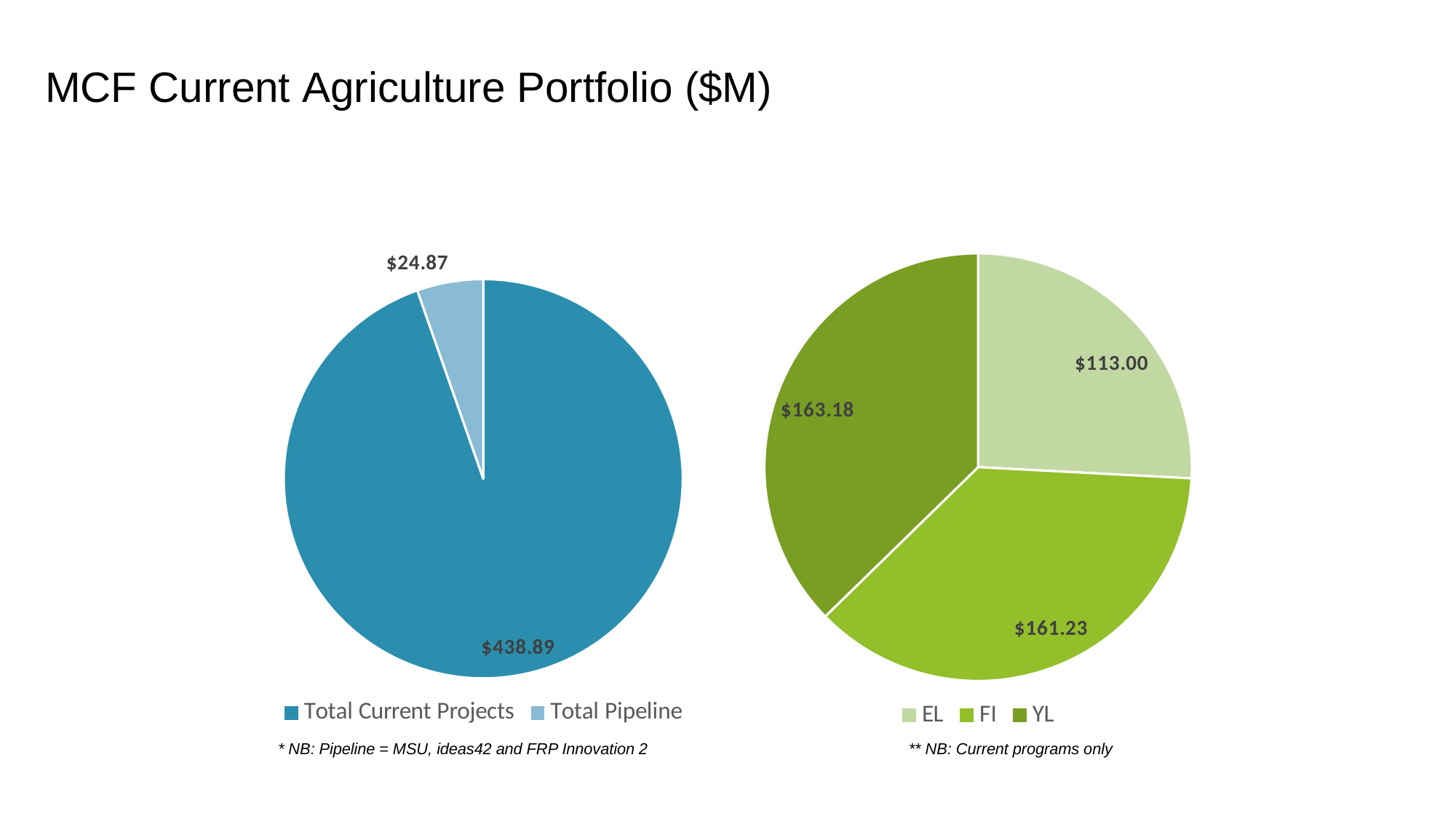
In the left pie chart, what is the value for Total Pipeline? $24.87 In the left pie chart, which category has the largest value? Total Current Projects What type of chart is the left chart on the slide? Pie chart How many categories does the right pie chart show? 3 In the right pie chart, which is larger, FI or EL? FI In the right pie chart, what is the value for YL? $163.18 In the right pie chart, which category has the smallest value? EL In the left pie chart, what is the difference between Total Current Projects and Total Pipeline? $414.02 In the right pie chart, what is the value for EL? $113.00 In the left pie chart, what is the value for Total Current Projects? $438.89 In the right pie chart, what is the difference between YL and EL? $50.18 In the right pie chart, what is the value for FI? $161.23